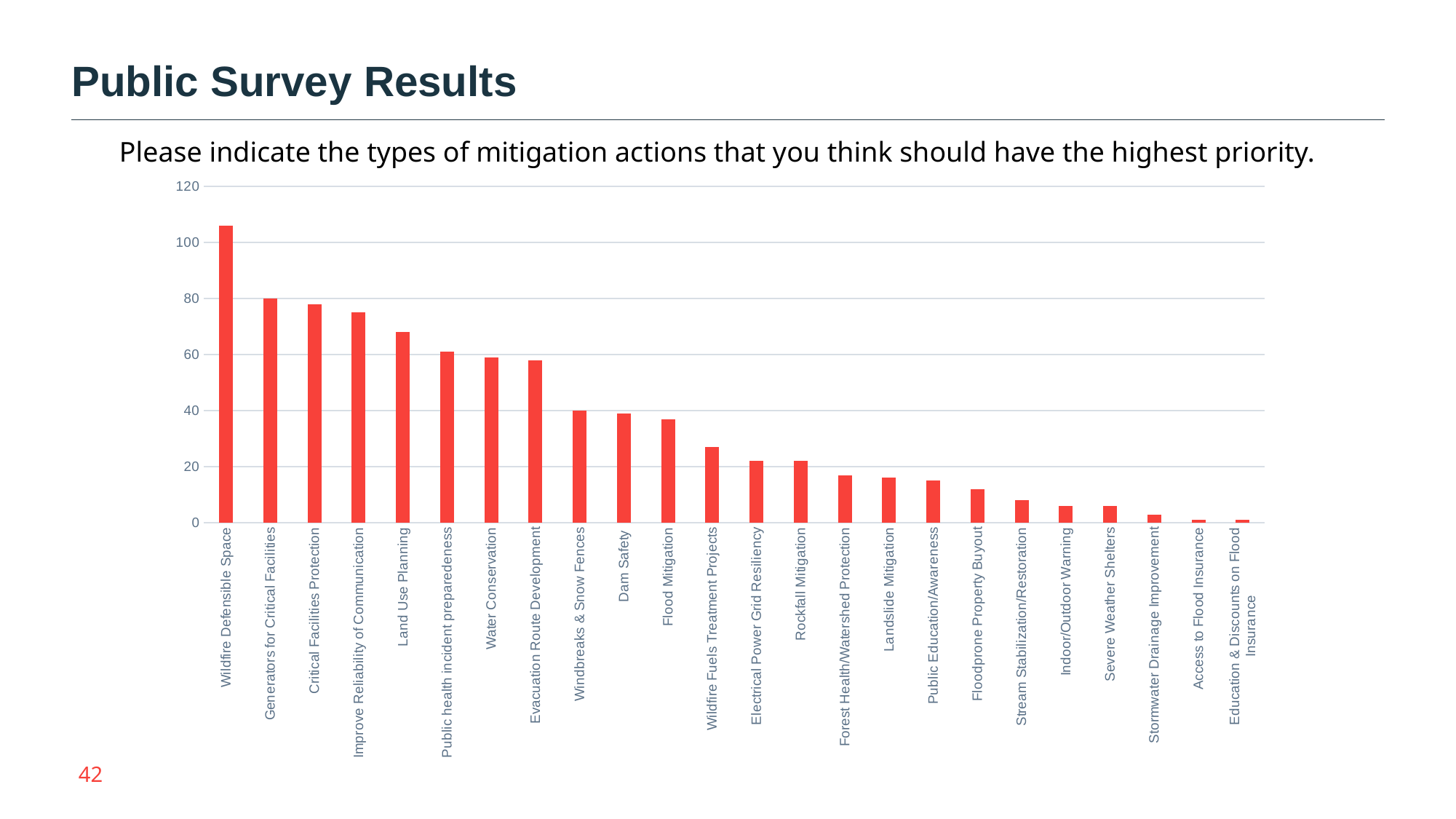
Is the value for Land Use Planning greater or less than 60? greater Is the value for Wildfire Fuels Treatment Projects greater or less than 20? greater How many mitigation action categories are plotted on the chart? 24 Is the value for Wildfire Defensible Space greater or less than 100? greater Which is larger, the value for Critical Facilities Protection or the value for Dam Safety? Critical Facilities Protection Do the values rise or fall moving from left to right along the x axis? fall Which mitigation action has the highest value? Wildfire Defensible Space What is the title of the slide containing the chart? Public Survey Results Which is larger, the value for Land Use Planning or the value for Public health incident preparedness? Land Use Planning What kind of chart is shown on the slide? bar chart